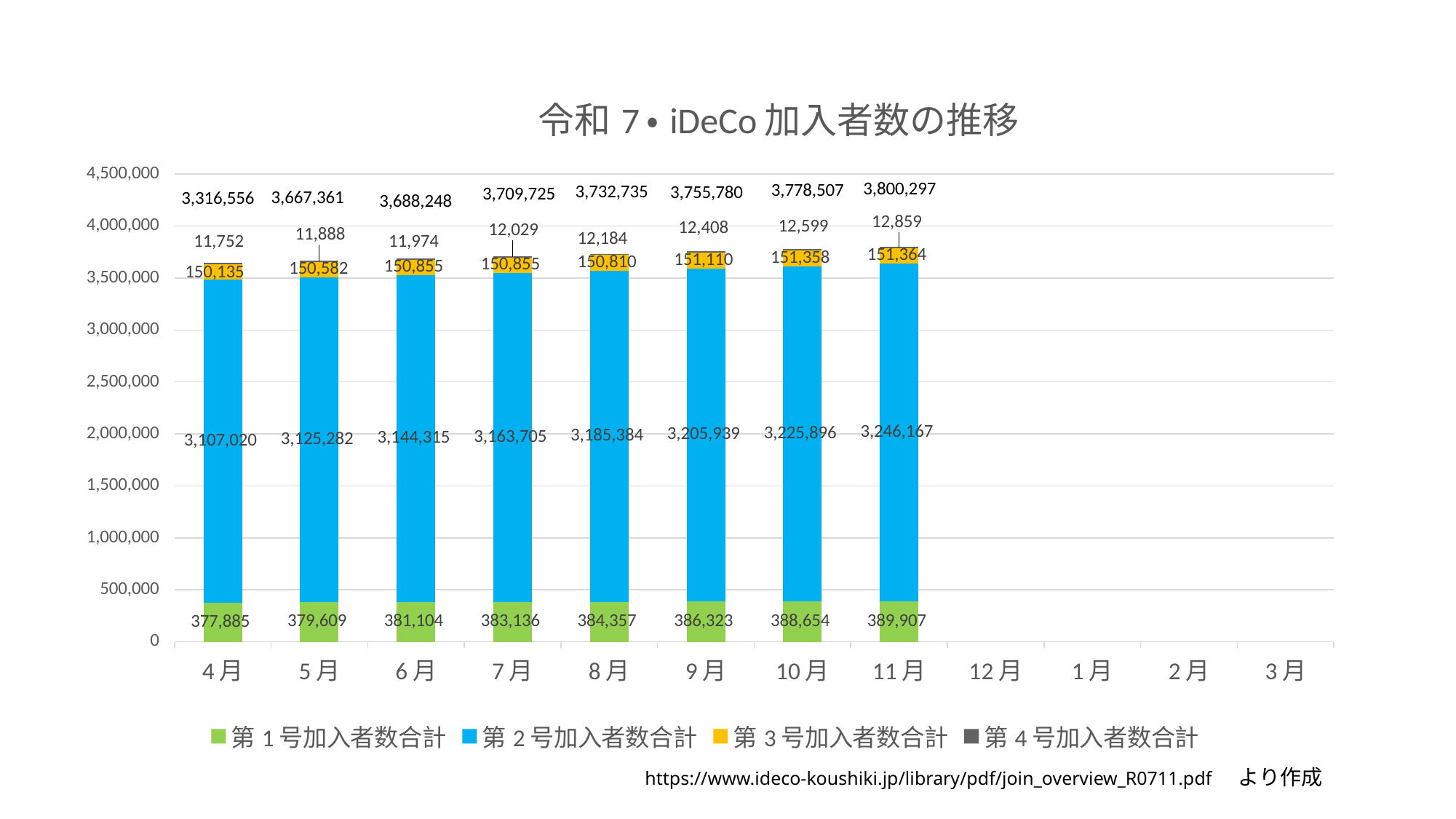
What is the title of the chart? 令和7・iDeCo加入者数の推移 Does 第2号加入者数合計 rise or fall from 4月 to 11月? rise What is the difference in 第2号加入者数合計 between 11月 and 10月? 20,271 In which month is 第2号加入者数合計 highest? 11月 What kind of chart is shown on the slide? stacked bar chart How many series does the legend list? 4 What is the value of 第1号加入者数合計 for 4月? 377,885 How many months have bars plotted on the chart? 8 What is the total of the stacked bar for 11月? 3,800,297 What is the value of 第4号加入者数合計 for 9月? 12,408 In which month is 第1号加入者数合計 lowest? 4月 What is the value of 第2号加入者数合計 for 7月? 3,163,705